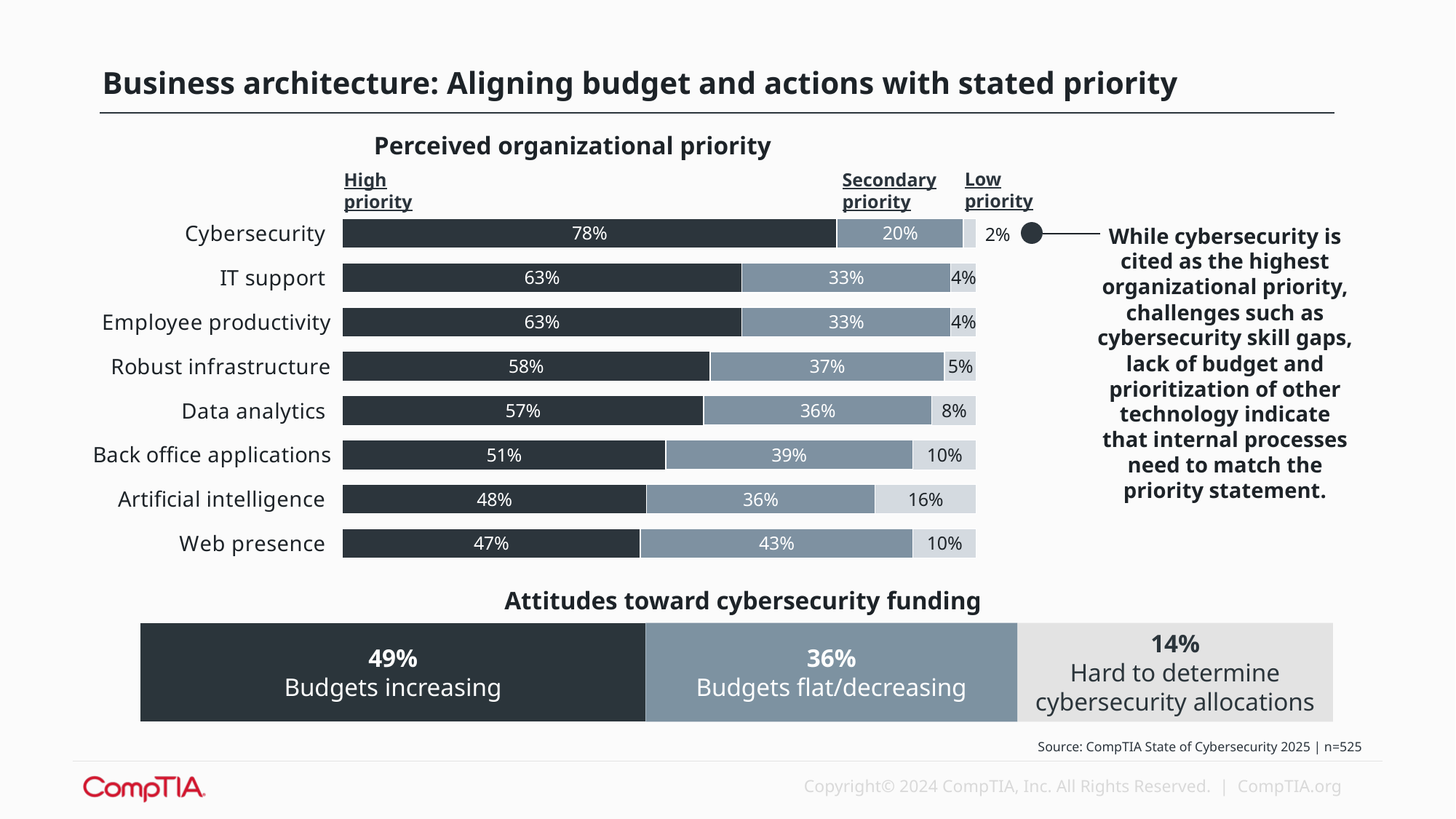
What kind of chart is the 'Perceived organizational priority' chart? Stacked bar chart In the 'Attitudes toward cybersecurity funding' chart, what is the difference between 'Budgets increasing' and 'Budgets flat/decreasing'? 13% In the 'Perceived organizational priority' chart, which category has the highest high-priority percentage? Cybersecurity In the 'Perceived organizational priority' chart, what is the low priority value for Artificial intelligence? 16% In the 'Perceived organizational priority' chart, what is the secondary priority value for Web presence? 43% In the 'Attitudes toward cybersecurity funding' chart, what percentage report budgets increasing? 49% In the 'Perceived organizational priority' chart, which category has the lowest high-priority percentage? Web presence How many categories are shown in the 'Perceived organizational priority' chart? 8 In the 'Perceived organizational priority' chart, what is the difference between the high-priority percentages for Cybersecurity and IT support? 15% How many priority levels (series) does the 'Perceived organizational priority' chart show? 3 In the 'Perceived organizational priority' chart, what percentage rate cybersecurity as a high priority? 78% In the 'Perceived organizational priority' chart, which has a larger high-priority percentage, Data analytics or Back office applications? Data analytics